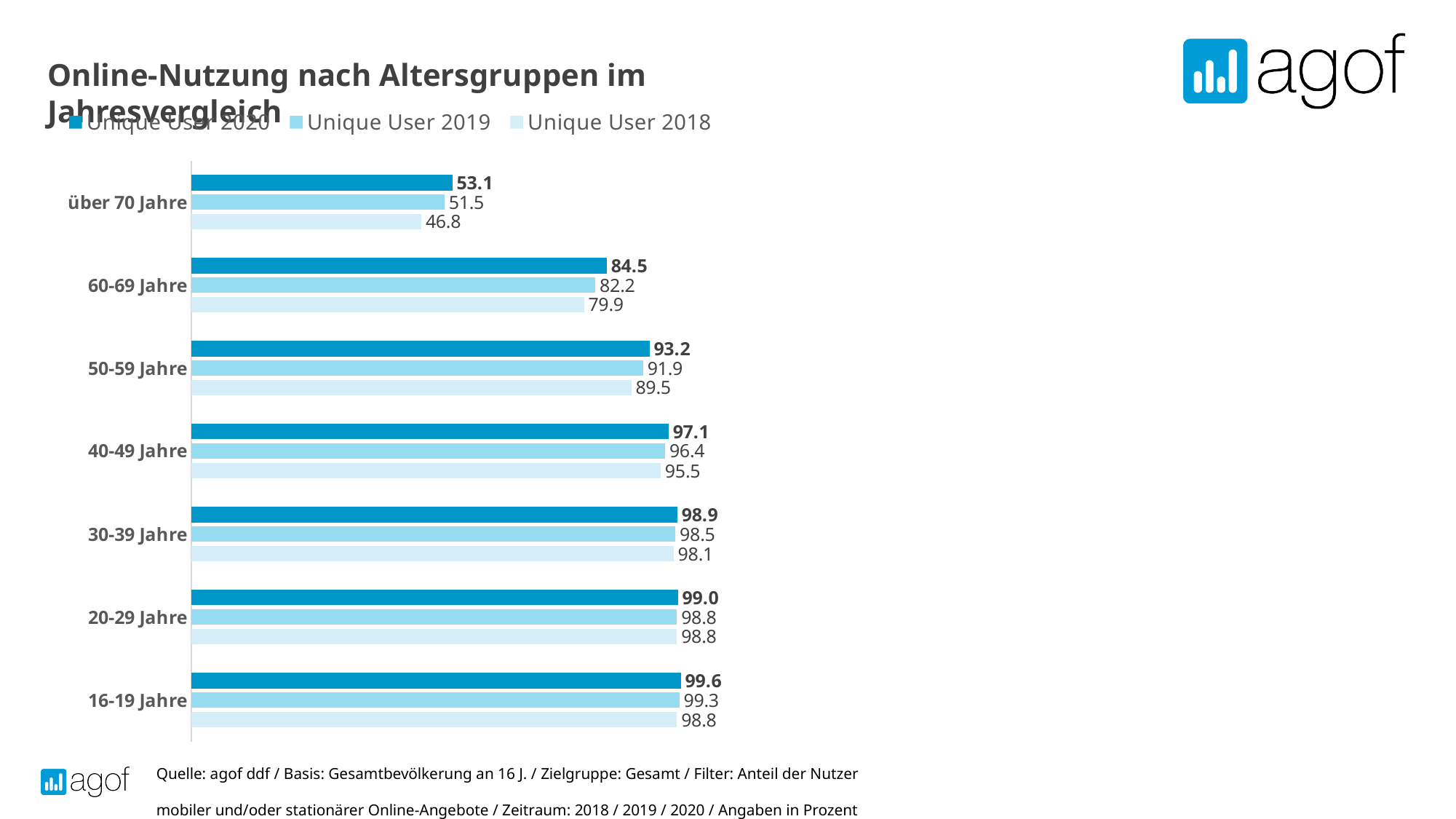
Which is larger: the Unique User 2020 value for '60-69 Jahre' or the Unique User 2019 value for '50-59 Jahre'? Unique User 2019 value for 50-59 Jahre Does the Unique User 2020 value rise or fall as the age groups get older, from '16-19 Jahre' to 'über 70 Jahre'? Fall What is the Unique User 2018 value for the '60-69 Jahre' age group? 79.9 What is the Unique User 2020 value for the 'über 70 Jahre' age group? 53.1 What is the Unique User 2019 value for the '50-59 Jahre' age group? 91.9 Which series is shown in the darkest blue colour? Unique User 2020 What is the difference between the Unique User 2020 and Unique User 2018 values for the 'über 70 Jahre' age group? 6.3 Which age group has the highest Unique User 2020 value? 16-19 Jahre How many series does the legend list? 3 What kind of chart is shown on the slide? Bar chart Which age group has the lowest Unique User 2020 value? über 70 Jahre How many age groups are shown on the chart? 7